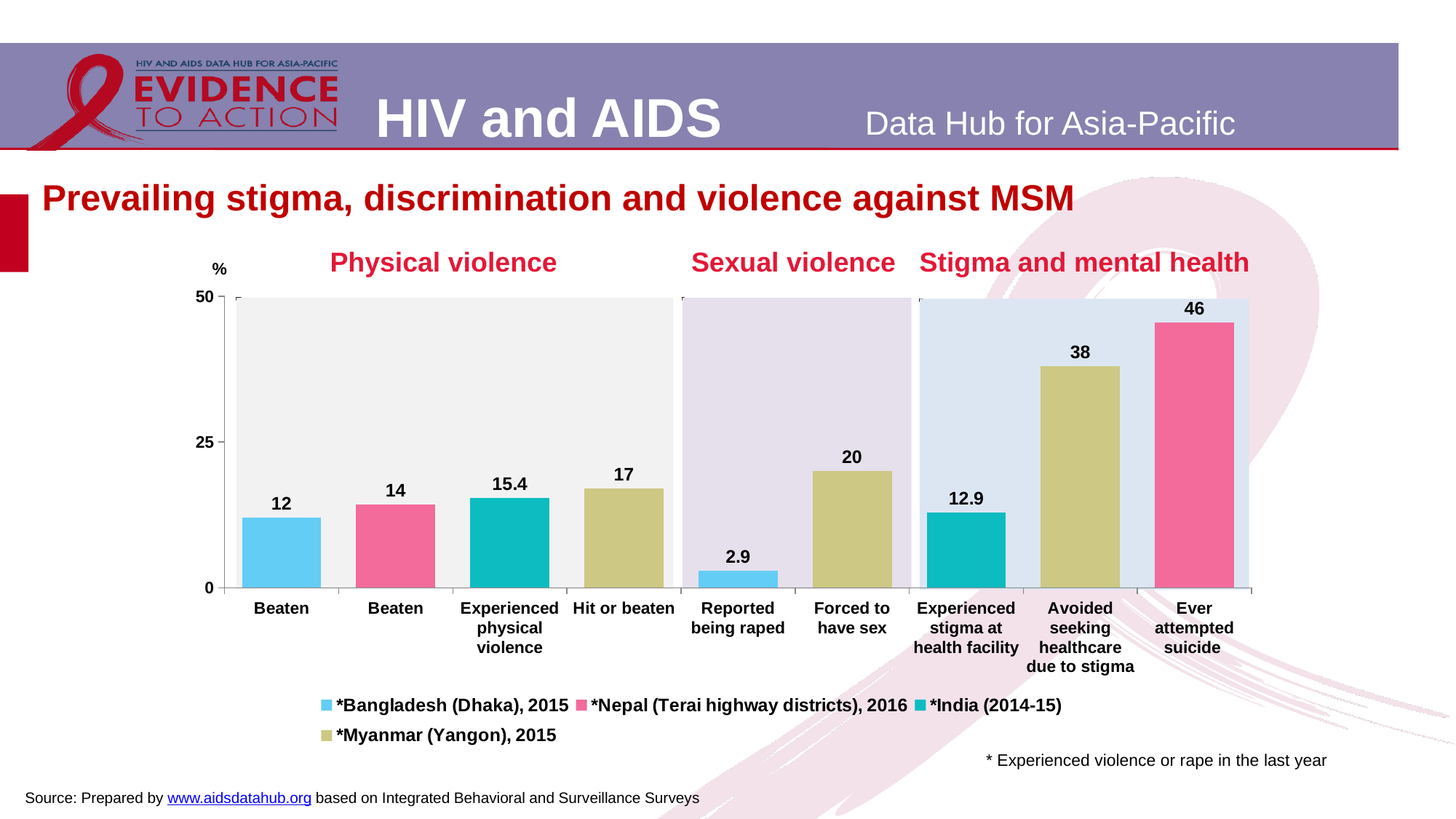
Which bar has the highest value on the chart? Ever attempted suicide What is the difference between 'Avoided seeking healthcare due to stigma' (38) and 'Experienced stigma at health facility' (12.9)? 25.1 How many bars are plotted on the chart in total? 9 Which is larger: 'Hit or beaten' for Myanmar or 'Beaten' for Bangladesh? Hit or beaten for Myanmar What is the value for 'Experienced stigma at health facility' for India? 12.9 Which bar has the lowest value on the chart? Reported being raped Which country does the pink colour represent in the legend? Nepal (Terai highway districts), 2016 How many series does the legend list? 4 What is the value for 'Ever attempted suicide' in the Stigma and mental health section? 46 What type of chart is shown on the slide? Bar chart What is the value for 'Reported being raped' in the Sexual violence section? 2.9 What percentage of MSM in Myanmar (Yangon) reported being forced to have sex? 20